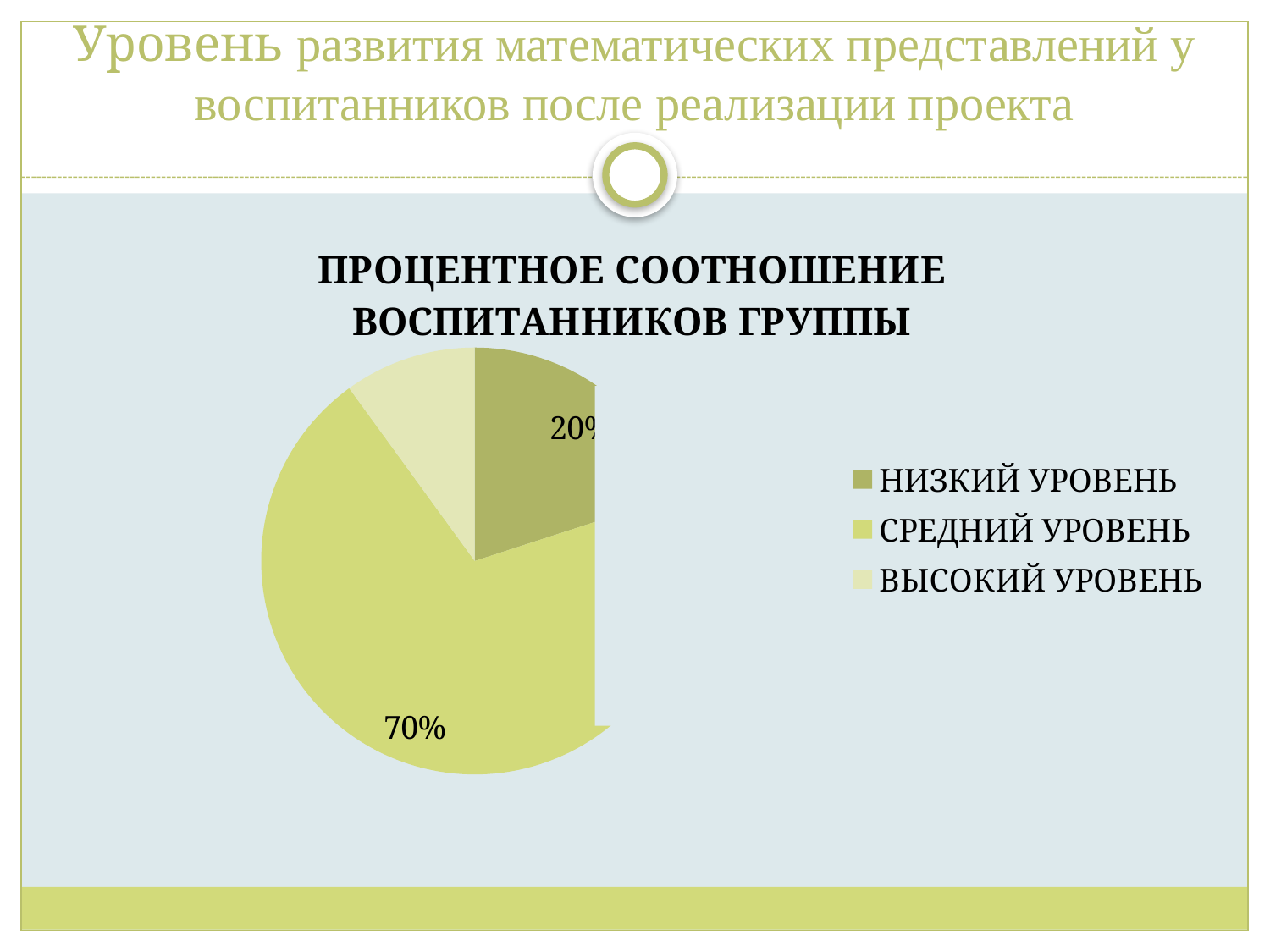
What kind of chart is shown on the slide? Pie chart What percentage of the pie chart is labelled for СРЕДНИЙ УРОВЕНЬ? 70% Which level has the smallest slice of the pie chart? ВЫСОКИЙ УРОВЕНЬ How many slices does the pie chart have? 3 What percentage of the pie chart is labelled for НИЗКИЙ УРОВЕНЬ? 20% By how many percentage points does СРЕДНИЙ УРОВЕНЬ exceed НИЗКИЙ УРОВЕНЬ? 50 percentage points Which slice is larger: НИЗКИЙ УРОВЕНЬ or СРЕДНИЙ УРОВЕНЬ? СРЕДНИЙ УРОВЕНЬ What share of the pie does СРЕДНИЙ УРОВЕНЬ take? 70% Which level has the largest slice of the pie chart? СРЕДНИЙ УРОВЕНЬ Which slice is larger: НИЗКИЙ УРОВЕНЬ or ВЫСОКИЙ УРОВЕНЬ? НИЗКИЙ УРОВЕНЬ What is the title of the chart? ПРОЦЕНТНОЕ СООТНОШЕНИЕ ВОСПИТАННИКОВ ГРУППЫ How many entries does the legend list? 3